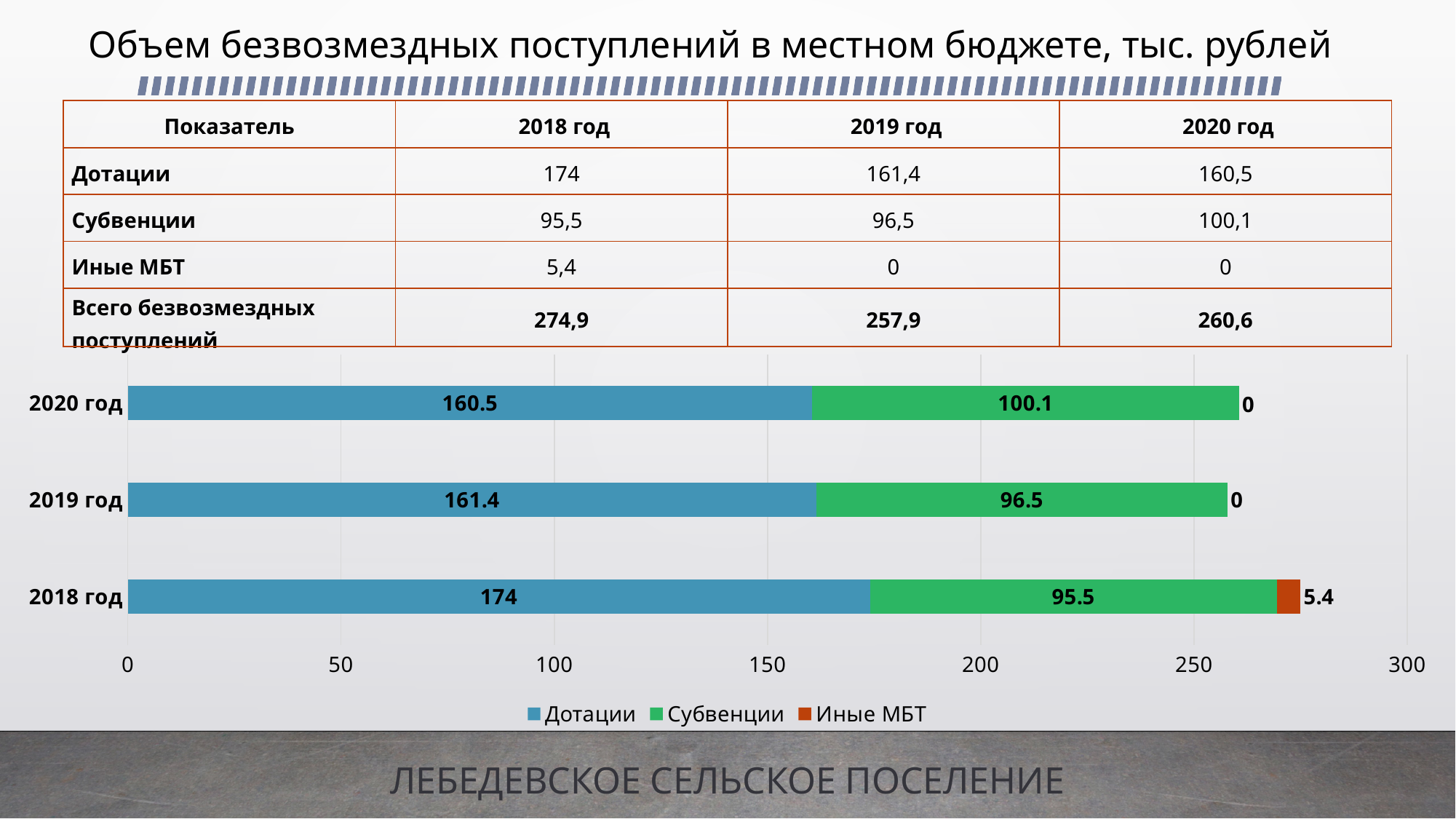
Which year has the lowest value for Субвенции? 2018 год What type of chart is shown on the slide? Stacked bar chart What is the total of the stacked bar for 2018 год? 274.9 Which is larger: Субвенции for 2019 год or Субвенции for 2020 год? 2020 год What is the total of the stacked bar for 2019 год? 257.9 How many years are shown on the chart? 3 What is the value of Дотации for 2018 год in the chart? 174 Which year has the highest value for Дотации? 2018 год What is the value of Иные МБТ for 2018 год in the chart? 5.4 What is the value of Субвенции for 2020 год in the chart? 100.1 How many series does the chart legend list? 3 What is the difference between the Дотации values for 2018 год and 2020 год? 13.5